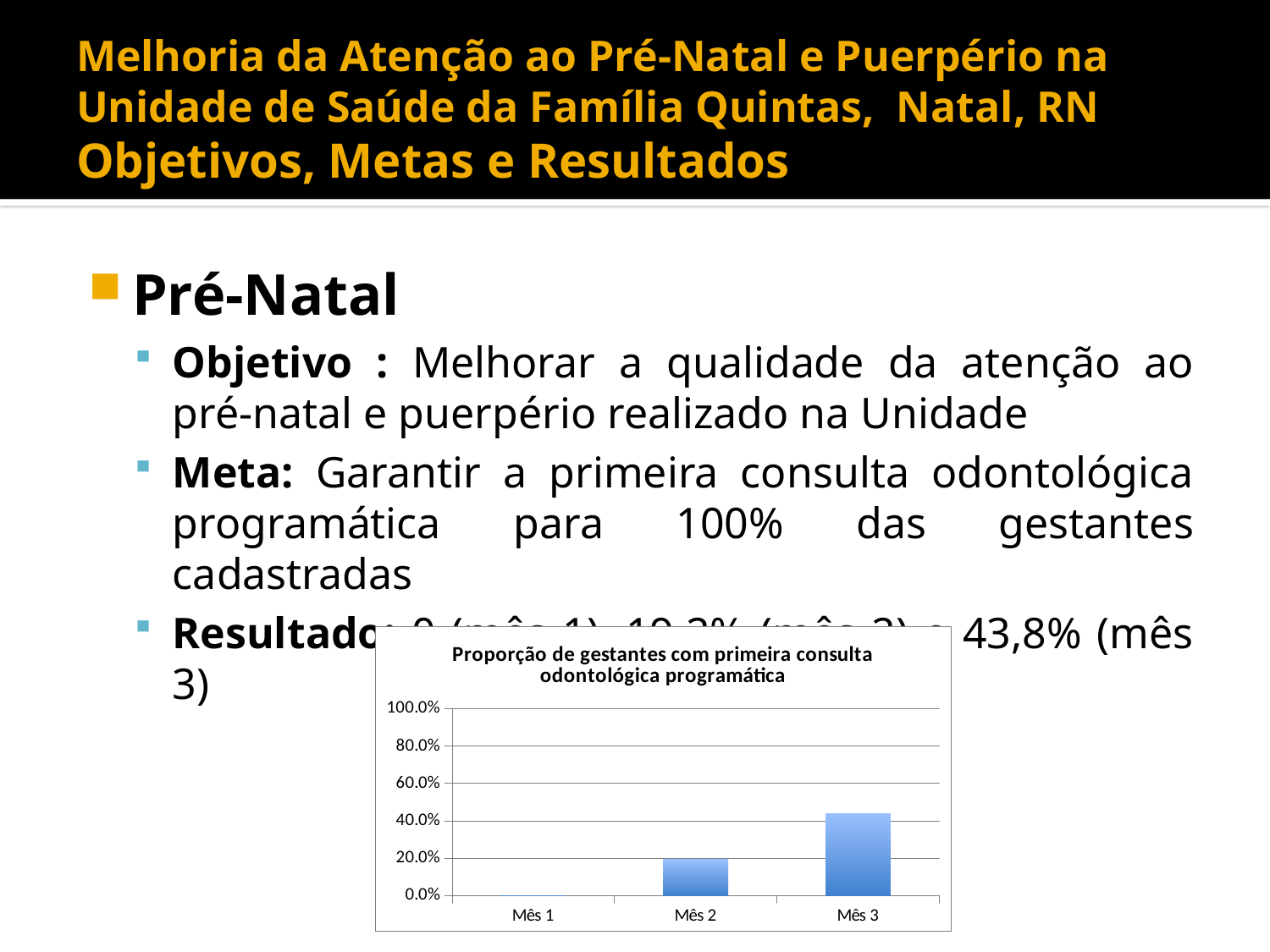
How many categories are plotted on the x axis of the chart? 3 Is the value for Mês 3 greater or less than 40.0%? greater What kind of chart is shown on the slide? bar chart Which month has the lowest value in the chart? Mês 1 Which is larger, the value for Mês 2 or the value for Mês 3? Mês 3 What is the highest value shown on the chart's y axis? 100.0% Which month has the highest proportion of pregnant women with a first programmatic dental consultation? Mês 3 Is the value for Mês 2 greater or less than 40.0%? less Is the value for Mês 3 greater or less than 60.0%? less What is the title of the chart? Proporção de gestantes com primeira consulta odontológica programática Do the values rise or fall from Mês 1 to Mês 3? rise